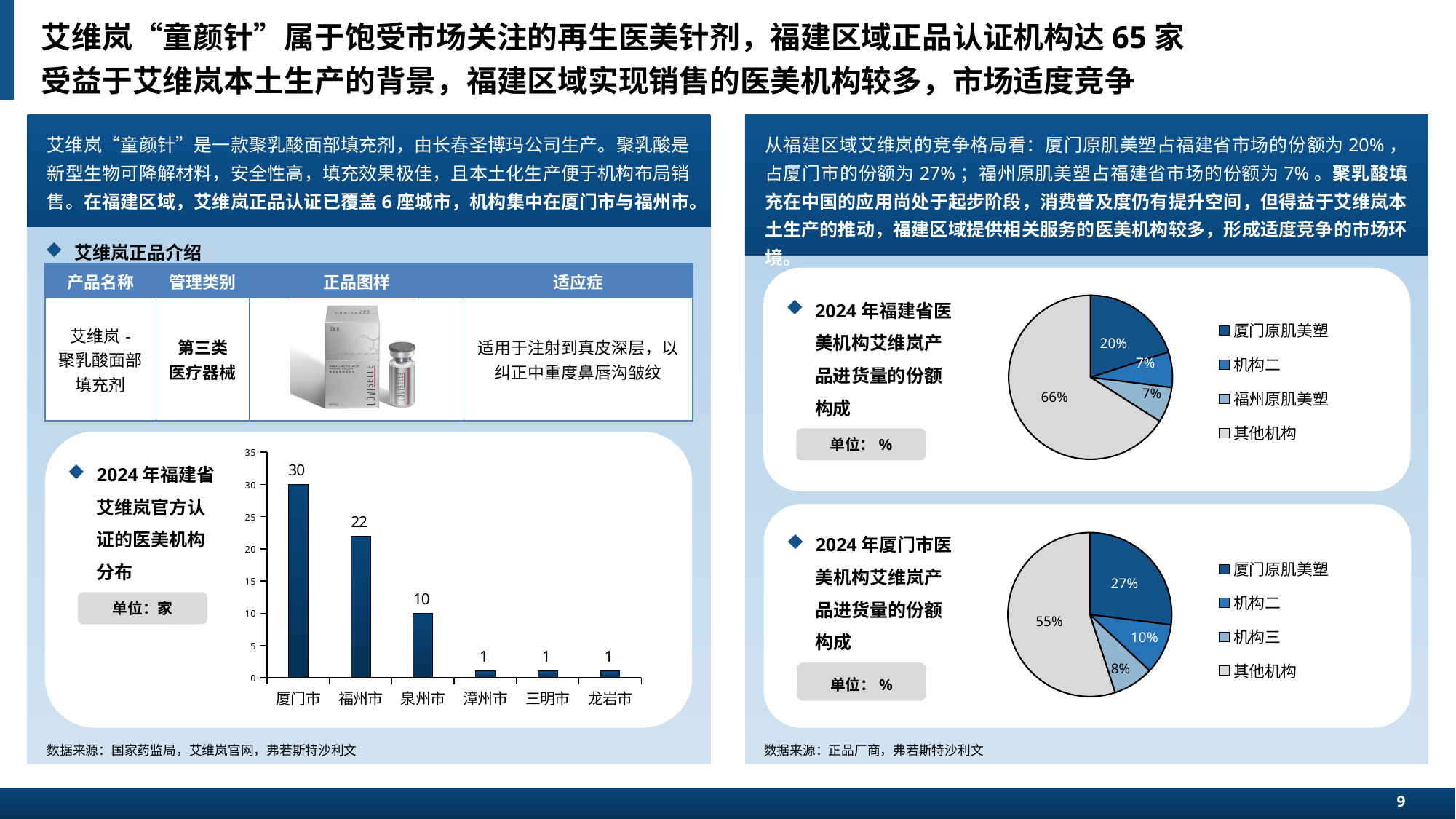
What kind of chart is the one titled 2024年福建省艾维岚官方认证的医美机构分布? bar chart In the bar chart titled 2024年福建省艾维岚官方认证的医美机构分布, which city has the highest value? 厦门市 In the bar chart titled 2024年福建省艾维岚官方认证的医美机构分布, how many cities are shown on the x axis? 6 In the bar chart titled 2024年福建省艾维岚官方认证的医美机构分布, do the values rise or fall from 厦门市 to 龙岩市 along the x axis? fall In the pie chart titled 2024年福建省医美机构艾维岚产品进货量的份额构成, what share does 福州原肌美塑 hold? 7% In the pie chart titled 2024年福建省医美机构艾维岚产品进货量的份额构成, what share does 厦门原肌美塑 hold? 20% How many entries does the legend of the pie chart titled 2024年厦门市医美机构艾维岚产品进货量的份额构成 list? 4 In the pie chart titled 2024年厦门市医美机构艾维岚产品进货量的份额构成, what share does 厦门原肌美塑 hold? 27% In the bar chart titled 2024年福建省艾维岚官方认证的医美机构分布, what is the difference between 厦门市 and 福州市? 8 In the pie chart titled 2024年厦门市医美机构艾维岚产品进货量的份额构成, which is larger, 机构二 or 机构三? 机构二 In the bar chart titled 2024年福建省艾维岚官方认证的医美机构分布, what is the value for 泉州市? 10 In the bar chart titled 2024年福建省艾维岚官方认证的医美机构分布, what is the value for 厦门市? 30